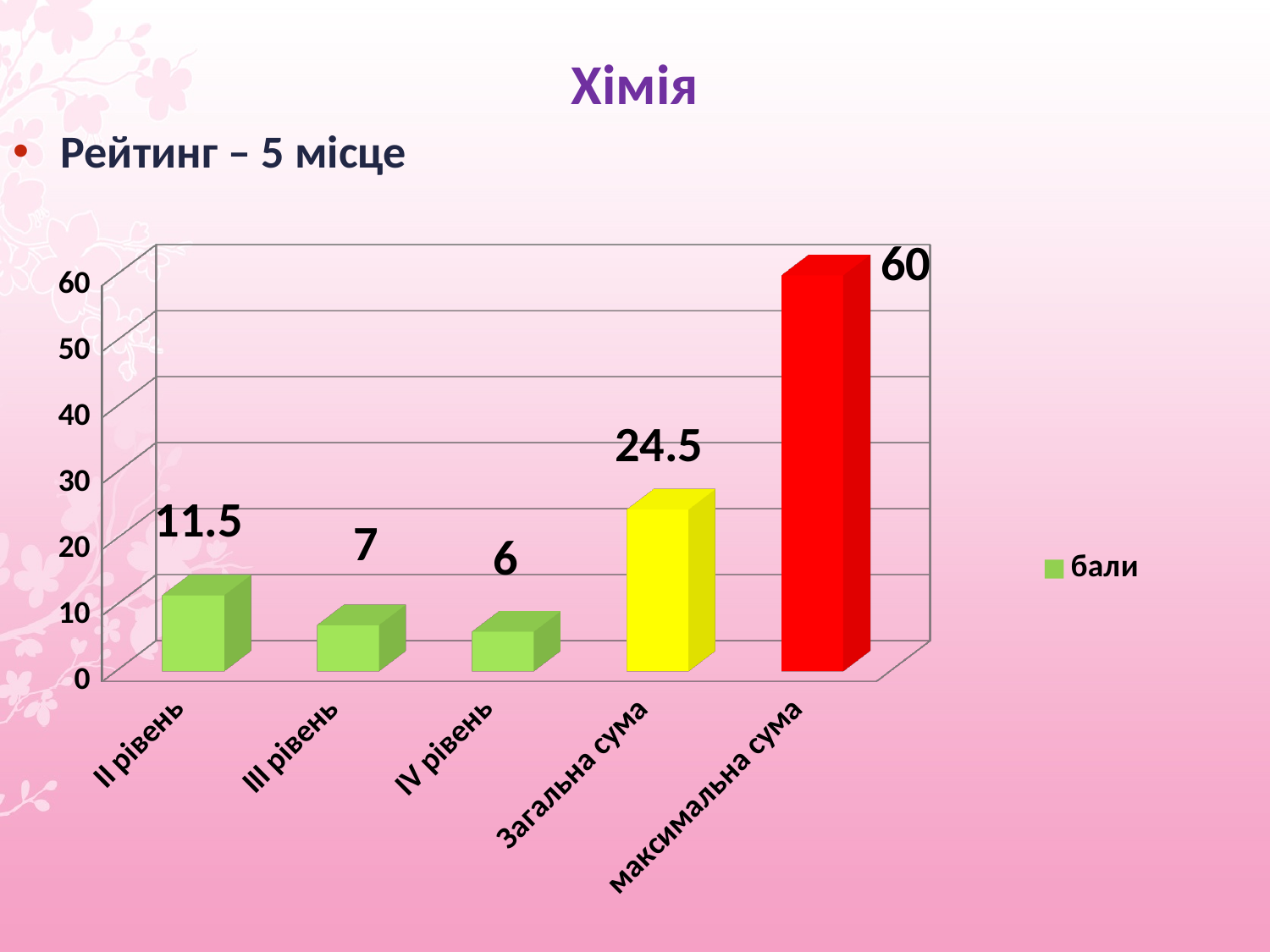
How many categories are shown on the x axis? 5 What is the value for максимальна сума? 60 What series name does the legend list? бали Which category has the highest value? максимальна сума What is the value for Загальна сума? 24.5 Which is larger, ІІ рівень or ІІІ рівень? ІІ рівень What is the value for IV рівень? 6 What is the difference between максимальна сума and Загальна сума? 35.5 Which category has the lowest value? IV рівень What is the value for ІІ рівень? 11.5 What kind of chart is shown? bar chart What is the value for ІІІ рівень? 7